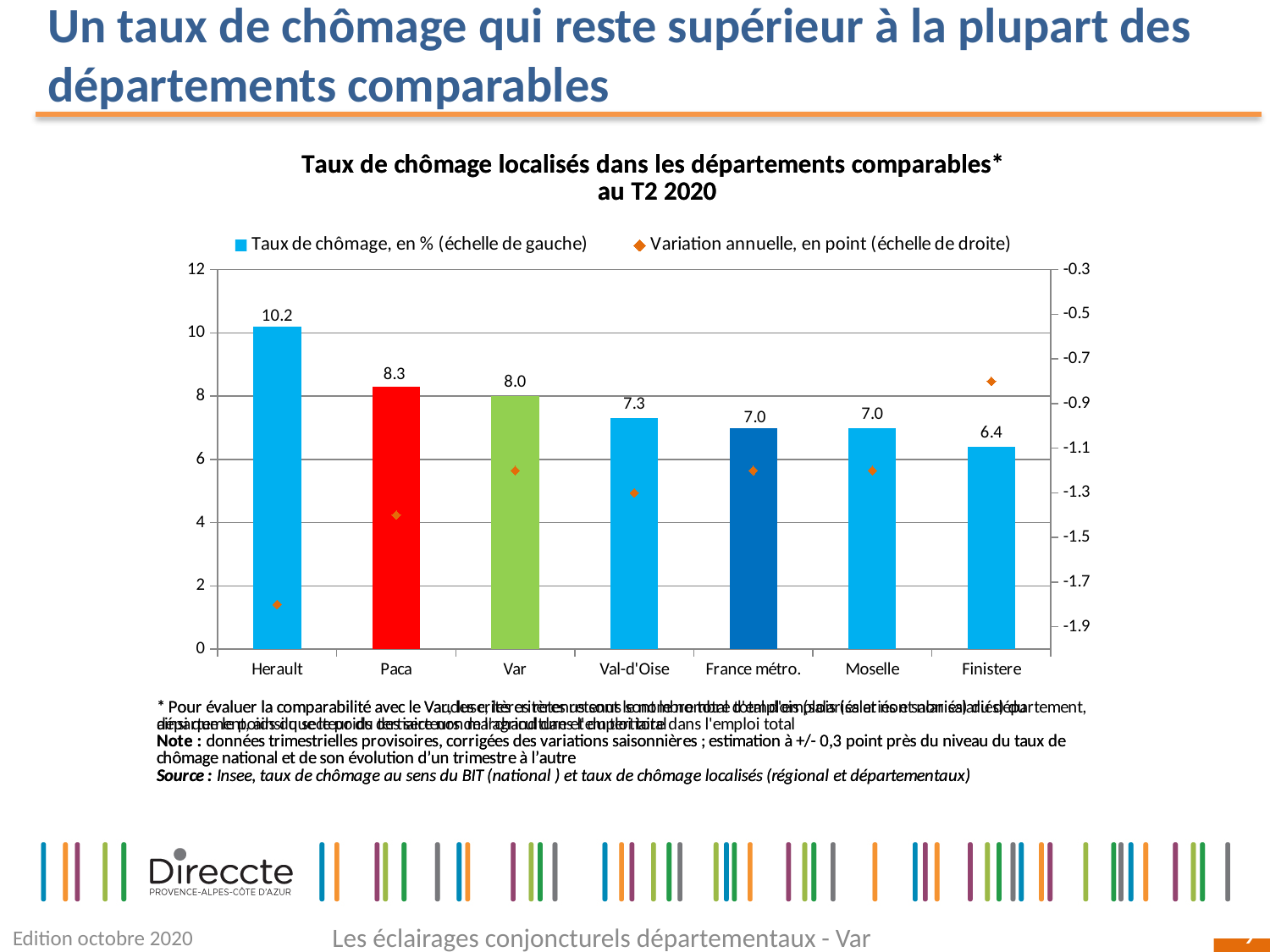
Do the unemployment rate bars rise or fall from left to right along the x axis? fall What is the unemployment rate shown for Finistere? 6.4 Which category has the lowest unemployment rate on the chart? Finistere Which has the higher unemployment rate, Paca or Val-d'Oise? Paca Which department has the highest unemployment rate on the chart? Herault What is the unemployment rate (Taux de chômage) shown for Var? 8.0 How many series does the legend list? 2 Is the annual variation (Variation annuelle) for Finistere greater or less than -0.9? greater Is the annual variation (Variation annuelle) for Herault greater or less than -1.5? less How many categories are shown on the x axis of the chart? 7 What is the difference between the unemployment rates of Herault and Var? 2.2 What is the unemployment rate shown for Herault? 10.2